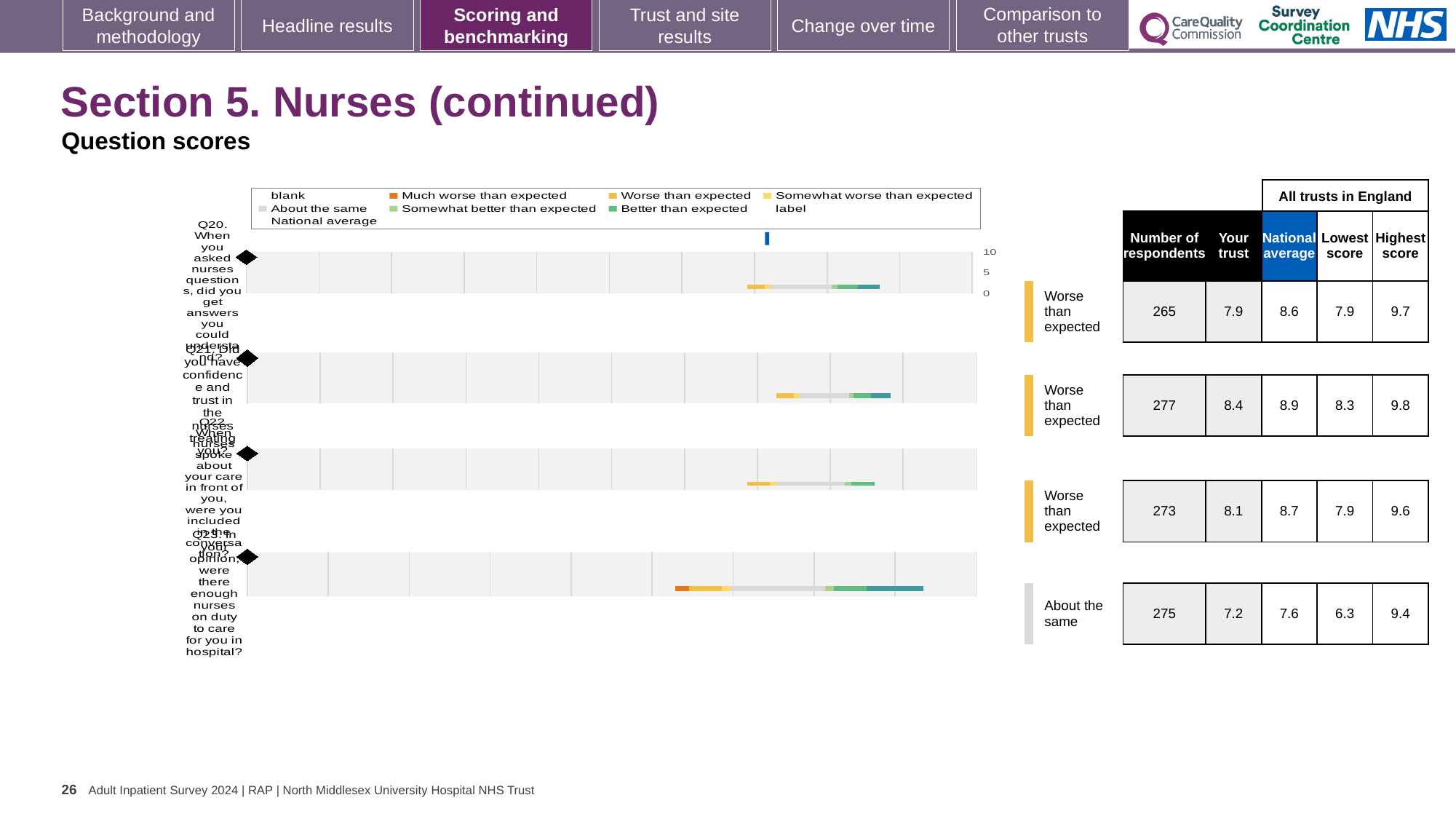
Which question has the lowest 'Your trust' score? Q23 For Q22, what is the difference between the national average and the 'Your trust' score? 0.6 For Q20, which is larger: the 'Your trust' score or the national average? National average Which question has the highest 'Your trust' score? Q21 Which benchmark category is shown for Q23? About the same What is the highest score across all trusts in England for Q21? 9.8 How many questions (categories) are plotted in the chart? 4 How many respondents answered Q23 (were there enough nurses on duty to care for you in hospital)? 275 What kind of chart is used to show the question scores for Q20 to Q23? bar chart What is the 'Your trust' score for Q20 (When you asked nurses questions, did you get answers you could understand)? 7.9 What is the national average score for Q21 (Did you have confidence and trust in the nurses treating you)? 8.9 What colour represents 'Much worse than expected' in the chart legend? Orange